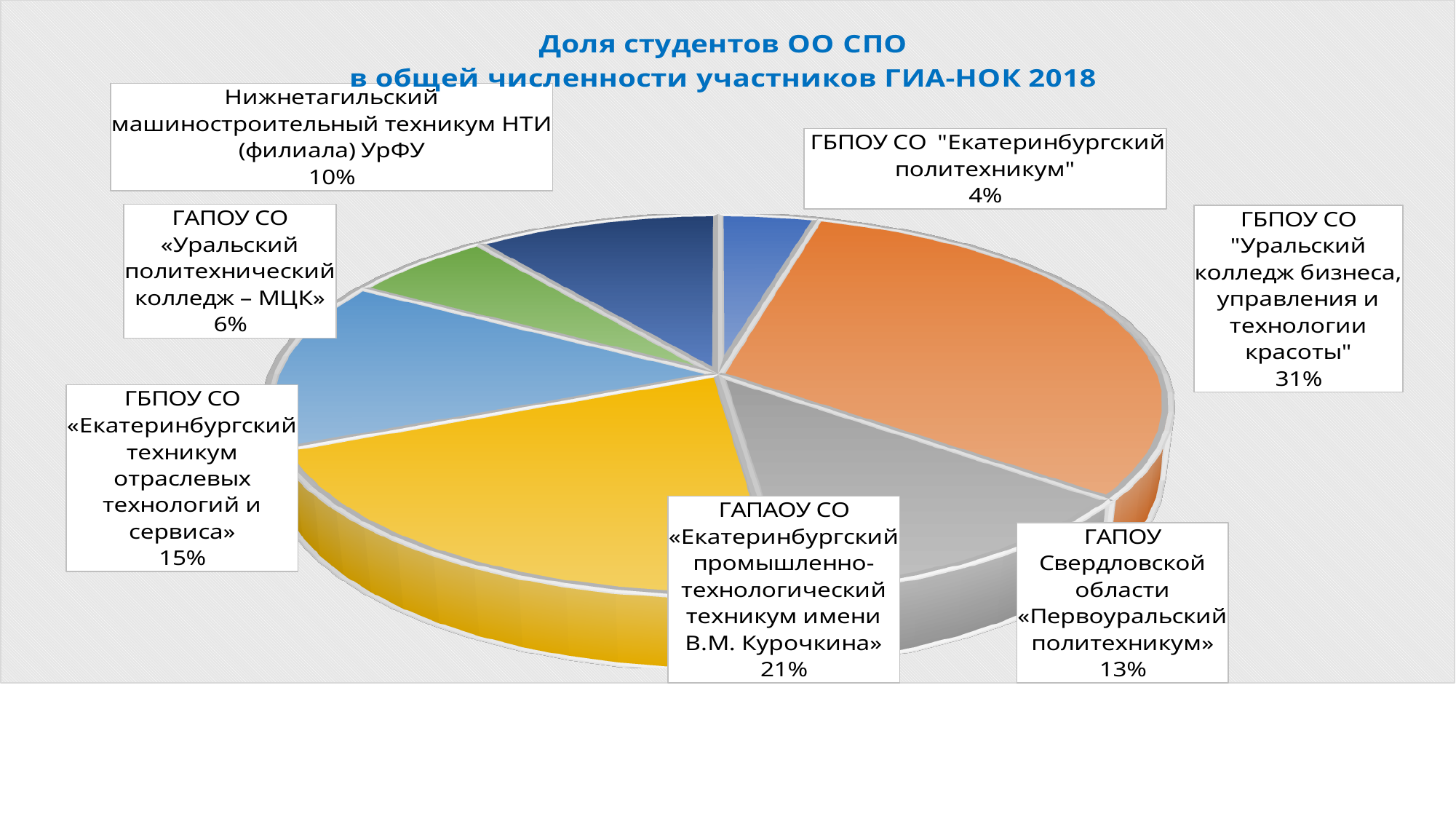
What is the difference in percentage points between ГАПАОУ СО «Екатеринбургский промышленно-технологический техникум имени В.М. Курочкина» and ГБПОУ СО «Екатеринбургский техникум отраслевых технологий и сервиса»? 6 percentage points What share does Нижнетагильский машиностроительный техникум НТИ (филиала) УрФУ have? 10% Which institution has the smallest share of the pie? ГБПОУ СО "Екатеринбургский политехникум" What type of chart is shown on the slide? Pie chart Which institution has the largest share of the pie? ГБПОУ СО "Уральский колледж бизнеса, управления и технологии красоты" What share does ГБПОУ СО "Екатеринбургский политехникум" have? 4% What is the title of the chart? Доля студентов ОО СПО в общей численности участников ГИА-НОК 2018 How many slices does the pie chart have? 7 Which has a larger share: ГАПОУ СО «Уральский политехнический колледж – МЦК» or ГАПОУ Свердловской области «Первоуральский политехникум»? ГАПОУ Свердловской области «Первоуральский политехникум» What share does ГАПОУ Свердловской области «Первоуральский политехникум» have? 13% What share does ГБПОУ СО "Уральский колледж бизнеса, управления и технологии красоты" have? 31% What colour is the slice for ГАПАОУ СО «Екатеринбургский промышленно-технологический техникум имени В.М. Курочкина» (21%)? Yellow